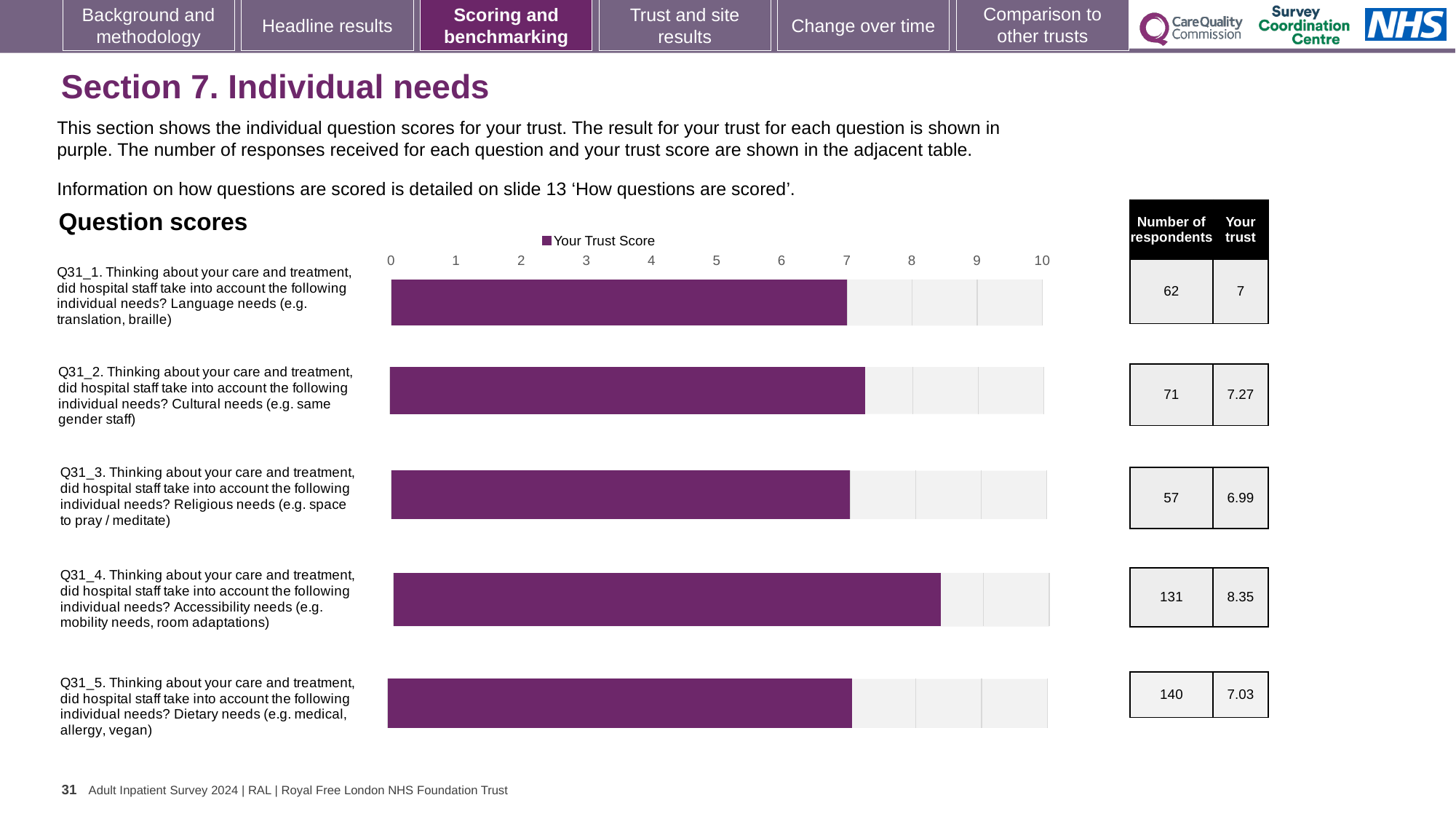
What is the difference between the trust scores for Q31_4 (Accessibility needs) and Q31_2 (Cultural needs)? 1.08 Which question has the highest trust score? Q31_4 (Accessibility needs) Which has the larger trust score, Q31_4 (Accessibility needs) or Q31_1 (Language needs)? Q31_4 (Accessibility needs) What is the trust score for Q31_4 (Accessibility needs)? 8.35 How many respondents answered Q31_5 (Dietary needs)? 140 Is the trust score for Q31_4 (Accessibility needs) greater or less than 8? greater What kind of chart is used to show the question scores? bar chart What is the difference between the trust scores for Q31_4 (Accessibility needs) and Q31_5 (Dietary needs)? 1.32 How many series does the legend of the Question scores chart list? 1 What is the trust score for Q31_3 (Religious needs)? 6.99 How many questions are plotted in the Question scores chart? 5 What is the trust score for Q31_2 (Cultural needs)? 7.27